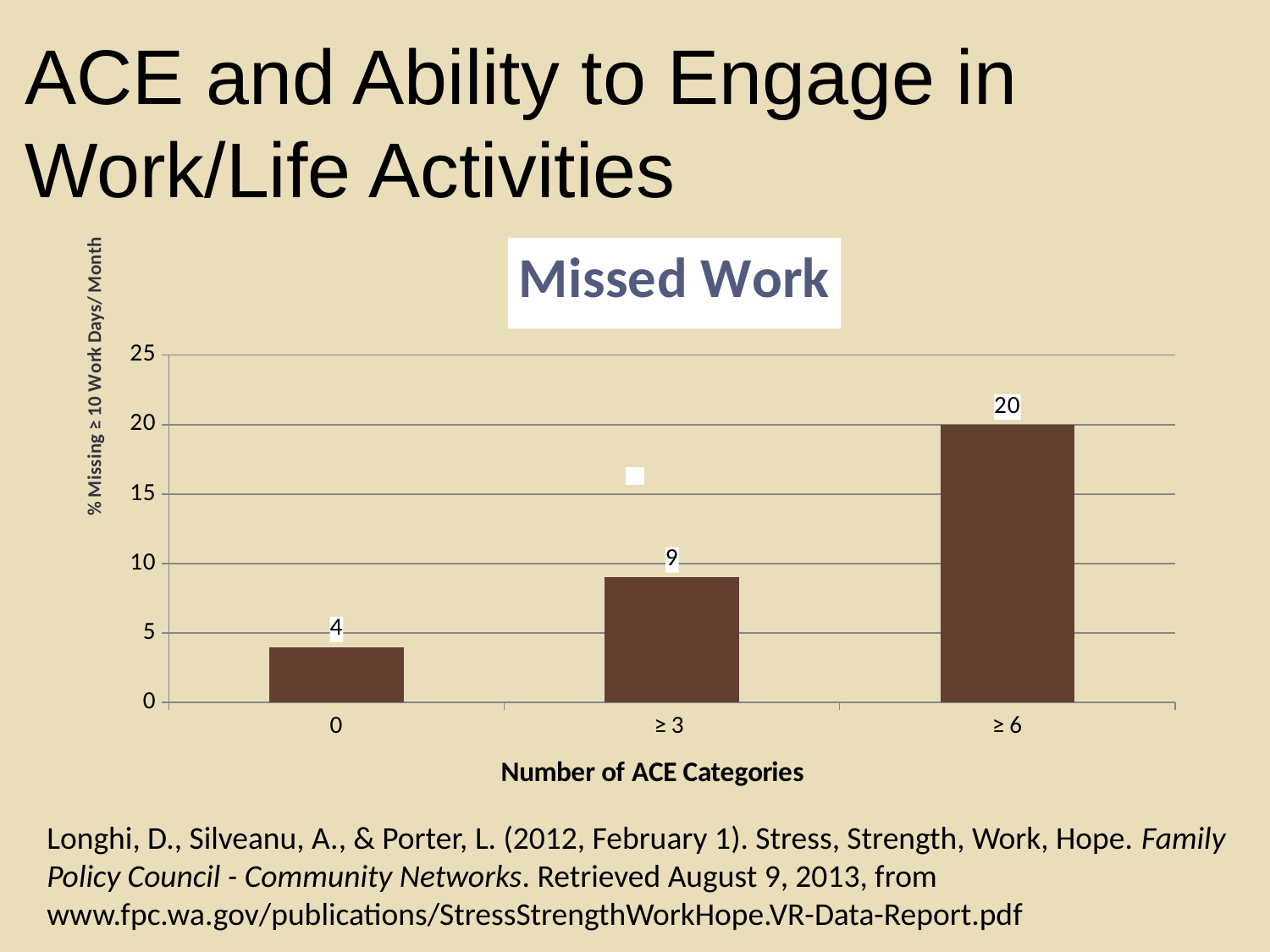
What is the difference between the values for ≥ 6 and 0 ACE categories? 16 Do the values rise or fall as the number of ACE categories increases? Rise Which ACE category has the lowest percentage missing ≥ 10 work days per month? 0 What is the value for the ≥ 6 ACE categories bar? 20 What is the title of the chart? Missed Work Which is larger, the value for ≥ 3 or the value for 0 ACE categories? ≥ 3 How many ACE categories are shown on the x axis? 3 What is the difference between the values for ≥ 6 and ≥ 3 ACE categories? 11 What is the value for the 0 ACE categories bar? 4 What kind of chart is shown on the slide? Bar chart Which ACE category has the highest percentage missing ≥ 10 work days per month? ≥ 6 What is the value for the ≥ 3 ACE categories bar? 9